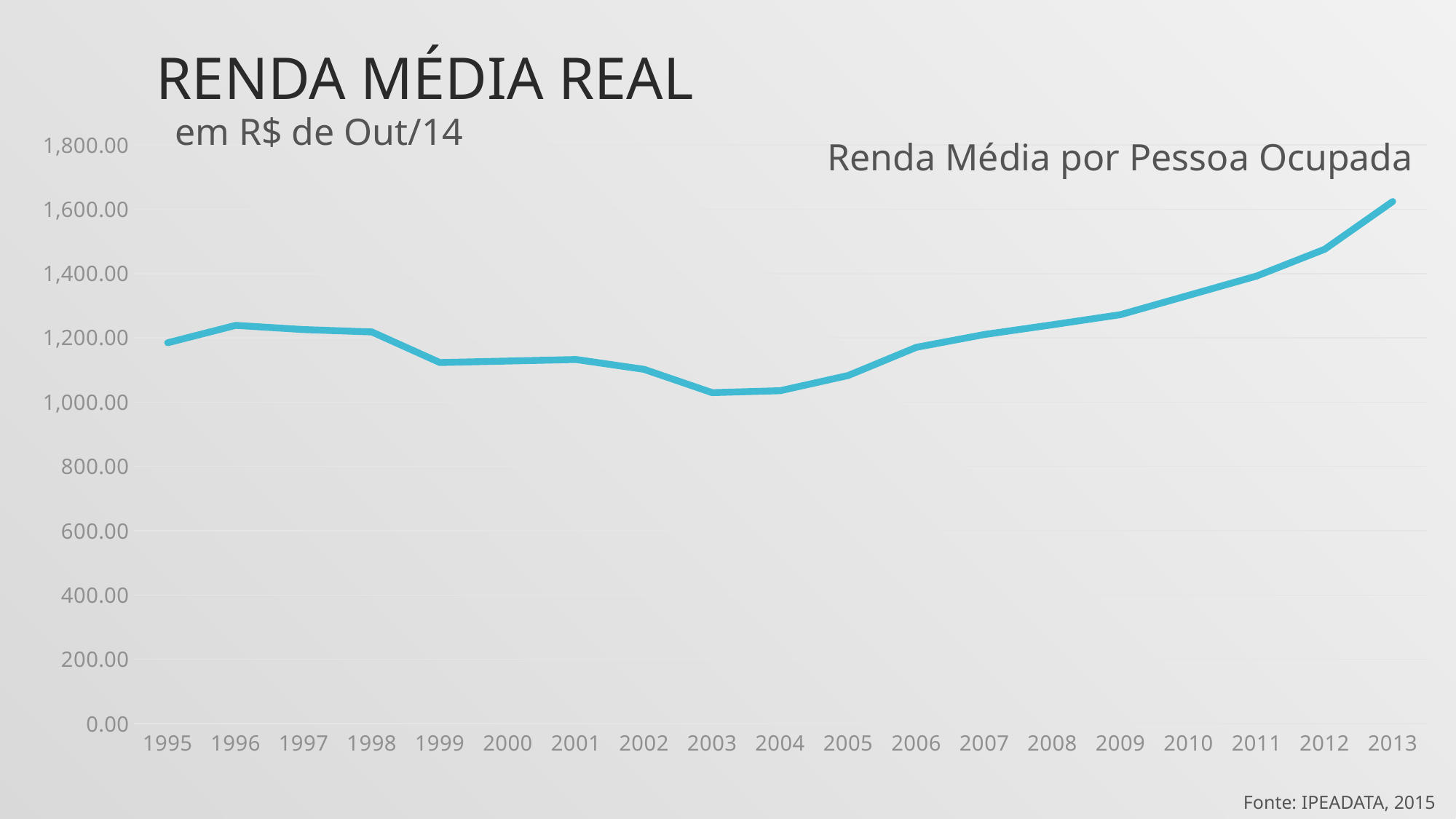
How many years are plotted along the x axis? 19 What kind of chart is shown on the slide? line chart Is the value for 2005 greater or less than 1,200.00? less Which year has the larger value, 1996 or 2003? 1996 How many data series does the chart show? 1 Is the value for 1999 greater or less than 1,200.00? less Which year has the larger value, 2011 or 2006? 2011 Do the values rise or fall from 2003 to 2013? rise What is the source cited at the bottom of the slide? IPEADATA, 2015 Which year has the highest value on the chart? 2013 Is the value for 2012 greater or less than 1,400.00? greater